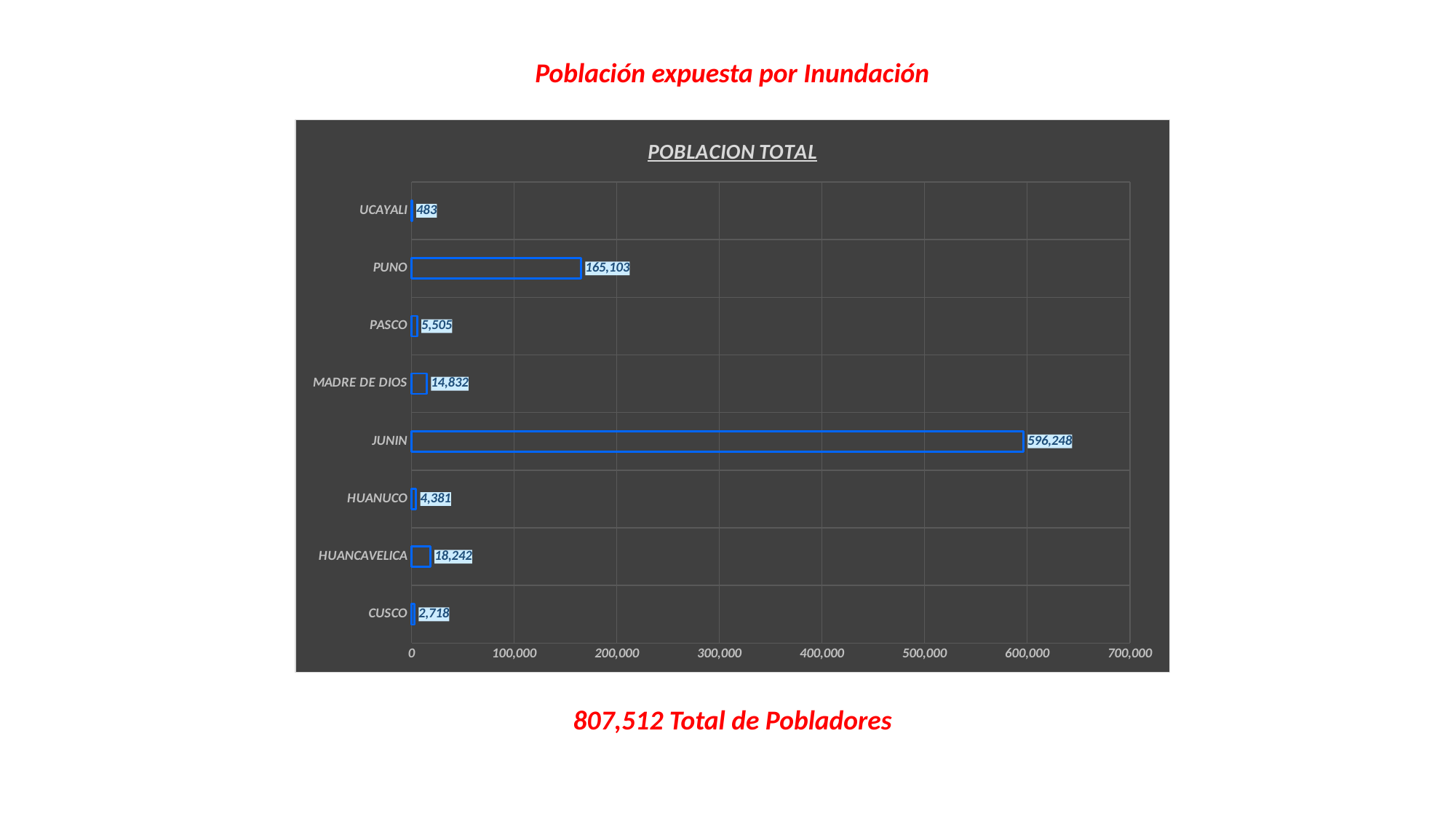
Which category has the highest value? JUNIN Is the value for PUNO greater or less than 100,000? greater What is the value for JUNIN? 596,248 What is the title of the chart? POBLACION TOTAL Which is larger, the value for HUANCAVELICA or the value for MADRE DE DIOS? HUANCAVELICA What is the value for MADRE DE DIOS? 14,832 What kind of chart is shown? bar chart What is the difference between the values for JUNIN and PUNO? 431,145 What is the value for HUANCAVELICA? 18,242 What is the value for PUNO? 165,103 Which category has the lowest value? UCAYALI How many categories are shown in the chart? 8